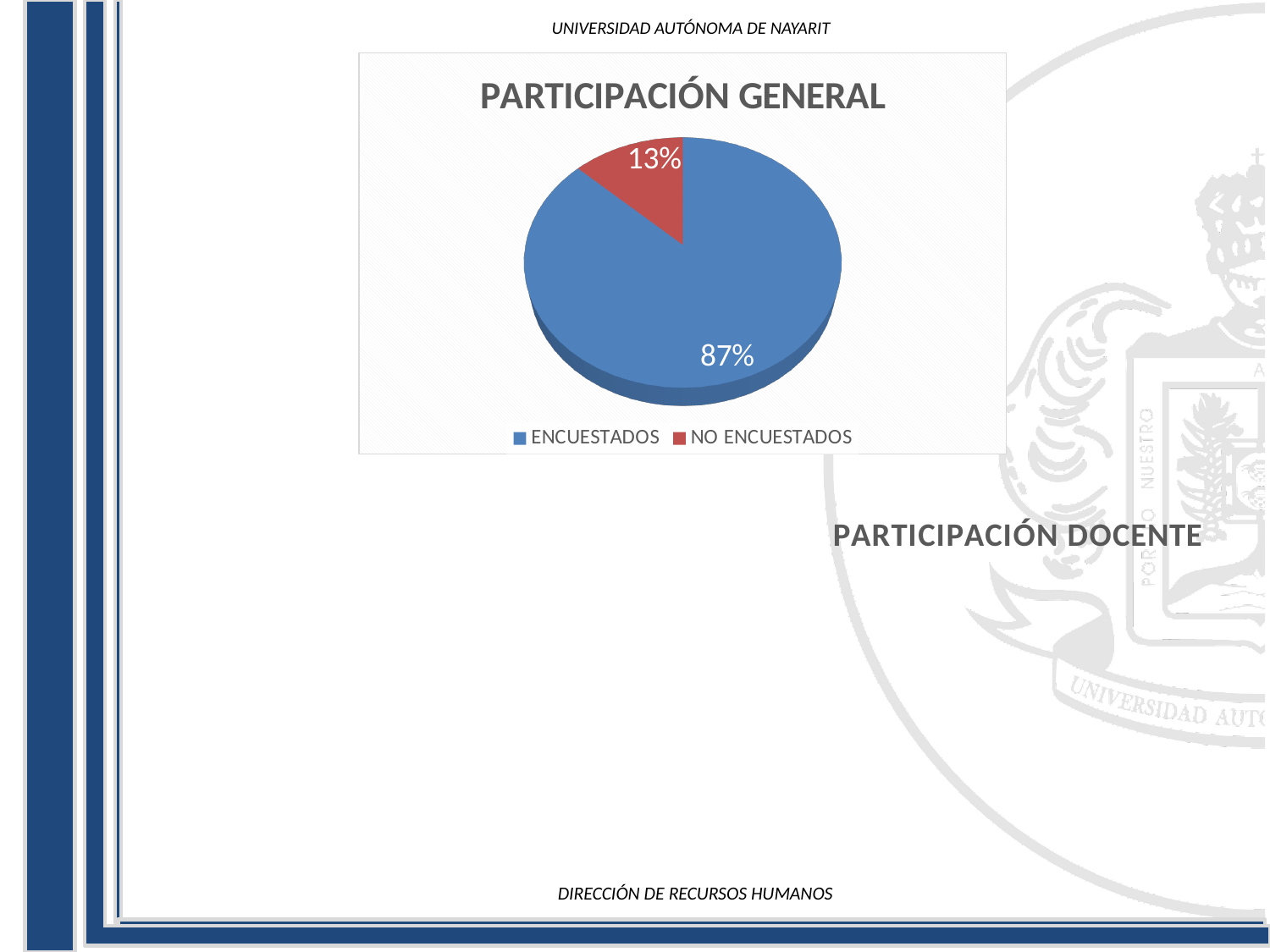
What colour is the NO ENCUESTADOS slice? Red What share of the pie does ENCUESTADOS represent? 87% What is the title of the chart? PARTICIPACIÓN GENERAL What share of the pie does NO ENCUESTADOS represent? 13% How many slices does the pie chart have? 2 How many entries does the legend list? 2 Which category has the smallest slice of the pie? NO ENCUESTADOS Which is larger, the ENCUESTADOS slice or the NO ENCUESTADOS slice? ENCUESTADOS What is the difference in percentage points between ENCUESTADOS and NO ENCUESTADOS? 74 Which category has the largest slice of the pie? ENCUESTADOS What kind of chart is shown on the slide? Pie chart